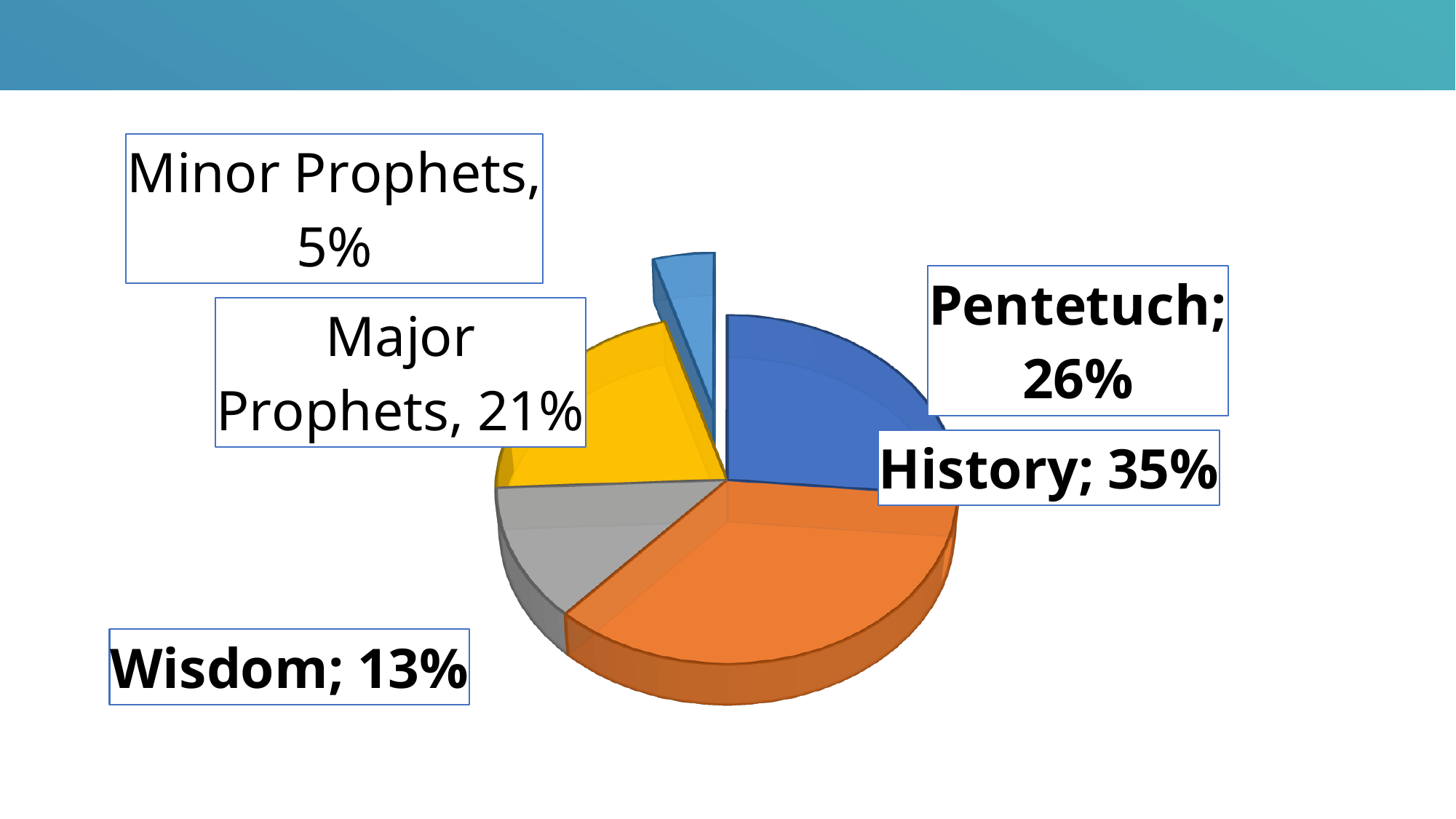
What share of the pie does Wisdom have? 13% What share of the pie do the Major Prophets have? 21% What share of the pie does History have? 35% Which category has the largest slice of the pie? History What colour is the History slice? orange How many slices does the pie chart have? 5 Which is larger, the share for Major Prophets or the share for Wisdom? Major Prophets What kind of chart is shown on the slide? pie chart What is the difference in percentage points between History and Pentetuch? 9 Which category has the smallest slice of the pie? Minor Prophets